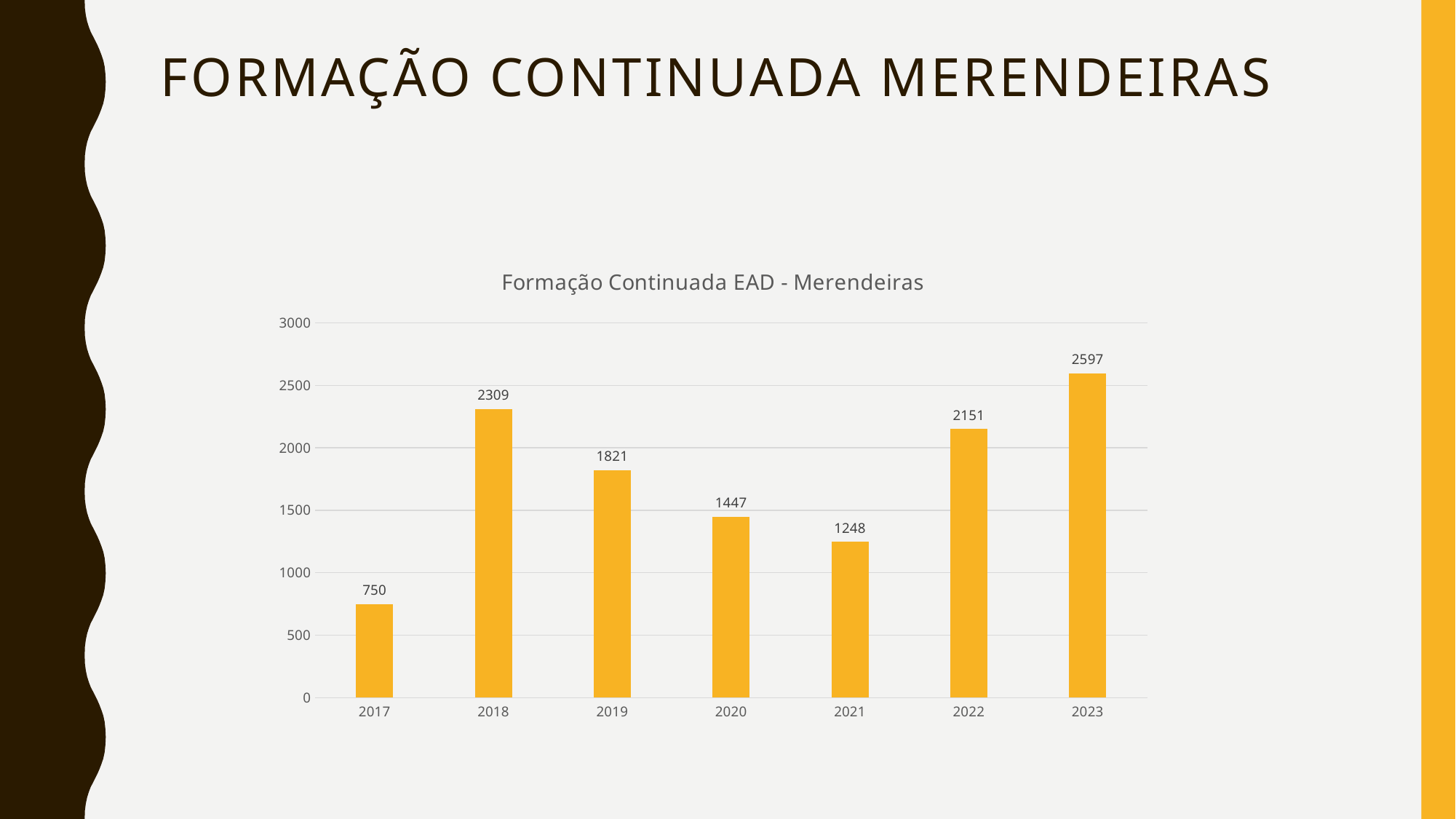
Which year has the lowest value? 2017 What is the title of the chart? Formação Continuada EAD - Merendeiras What is the difference between the values for 2023 and 2017? 1847 How many years are shown on the x axis? 7 Which is larger, the value for 2019 or the value for 2021? 2019 What kind of chart is shown on the slide? bar chart What is the value for 2020? 1447 What is the value for 2017? 750 Is the value for 2021 greater or less than 1500? less What is the difference between the values for 2018 and 2019? 488 Which year has the highest value? 2023 What is the value for 2022? 2151